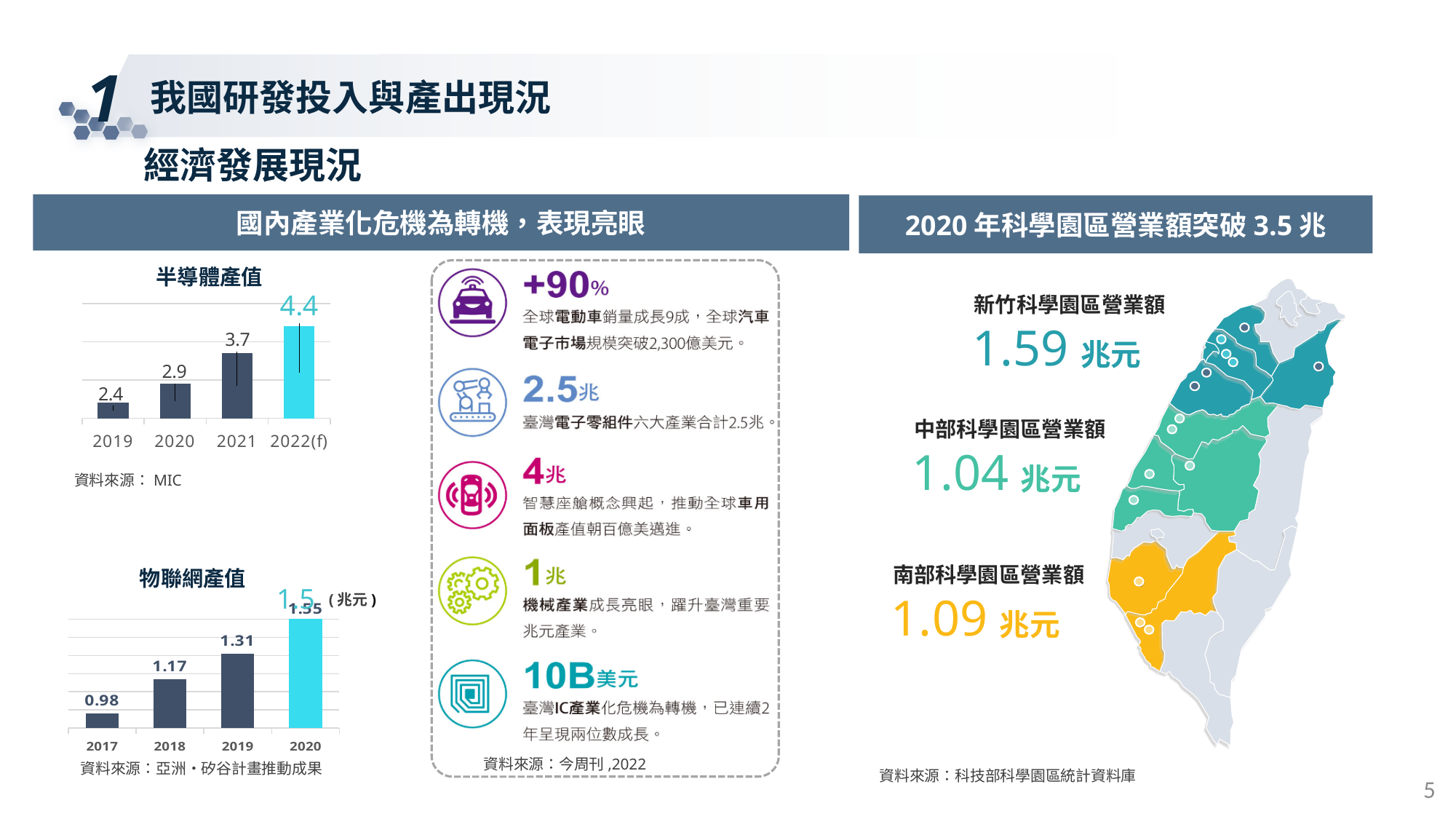
In the 物聯網產值 chart, what is the value for 2018? 1.17 In the 半導體產值 chart, which year has the lowest value? 2019 In the 物聯網產值 chart, what is the value for 2017? 0.98 In the 半導體產值 chart, what is the difference between the 2022(f) value and the 2020 value? 1.5 In the 物聯網產值 chart, which year has the highest value? 2020 In the 半導體產值 chart, which year has the highest value? 2022(f) In the 半導體產值 chart, do the values rise or fall from 2019 to 2022(f)? rise What kind of chart is the 物聯網產值 chart? bar chart In the 半導體產值 chart, how many years are plotted? 4 In the 半導體產值 chart, what is the value for 2021? 3.7 In the 半導體產值 chart, what is the value for 2019? 2.4 In the 物聯網產值 chart, what is the difference between the 2019 value and the 2018 value? 0.14